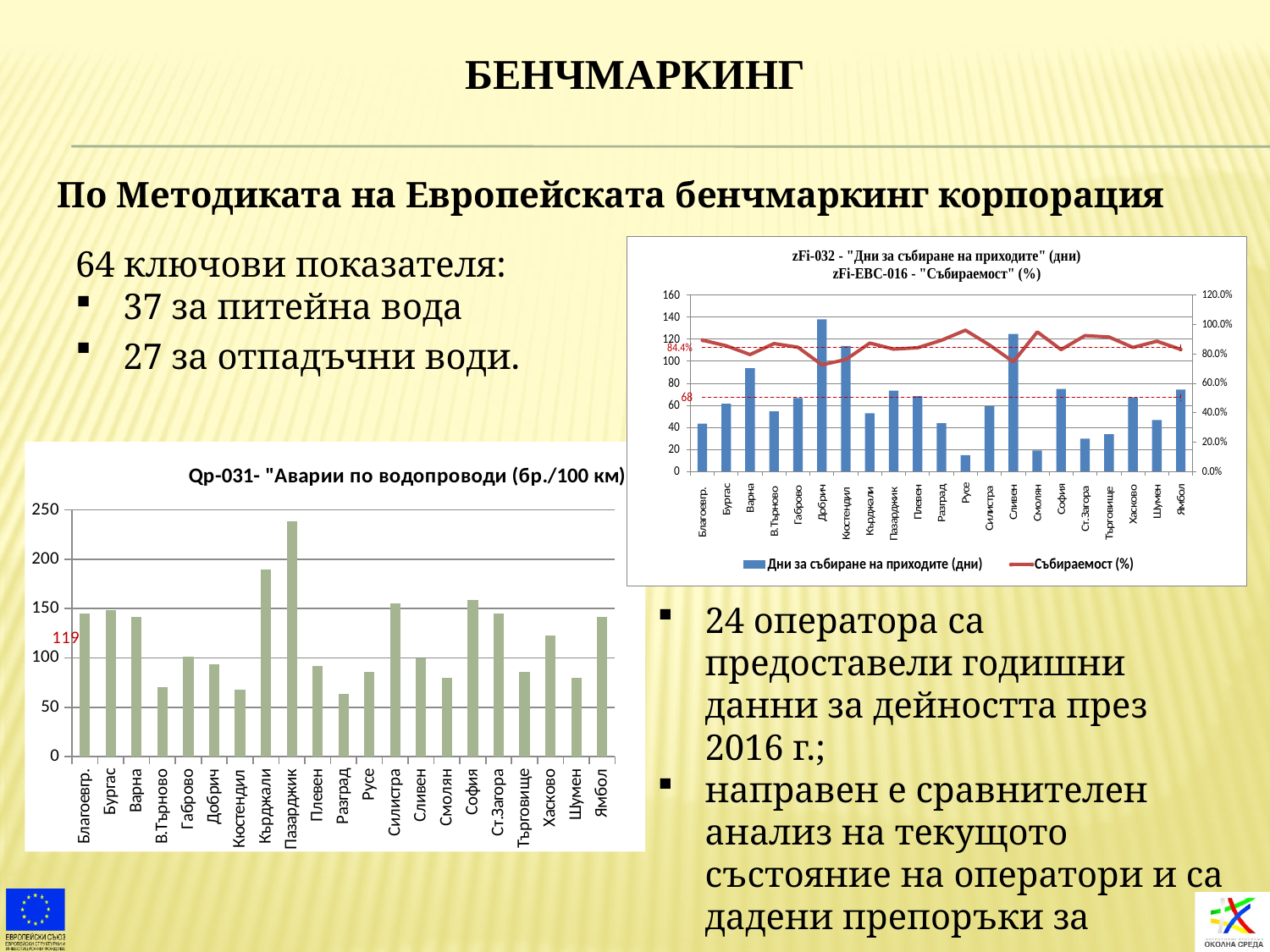
What kind of chart is the Qp-031 "Аварии по водопроводи" chart? bar chart In the Qp-031 "Аварии по водопроводи" chart, is the value for Разград greater or less than 100? less In the Qp-031 "Аварии по водопроводи" chart, which category has the highest bar? Пазарджик In the zFi-032 / zFi-EBC-016 chart, which has the taller bar, Варна or Бургас? Варна In the Qp-031 "Аварии по водопроводи" chart, which has the larger value, Кърджали or София? Кърджали What value is printed in red next to the horizontal reference line on the Qp-031 "Аварии по водопроводи" chart? 119 How many categories are shown on the x axis of the Qp-031 "Аварии по водопроводи" chart? 21 In the zFi-032 / zFi-EBC-016 chart, is the bar for Сливен greater or less than 100? greater How many series does the legend of the zFi-032 / zFi-EBC-016 chart list? 2 In the Qp-031 "Аварии по водопроводи" chart, is the value for Пазарджик greater or less than 200? greater In the zFi-032 / zFi-EBC-016 chart, which category has the lowest bar for "Дни за събиране на приходите (дни)"? Русе In the zFi-032 / zFi-EBC-016 chart, which category has the highest bar for "Дни за събиране на приходите (дни)"? Добрич